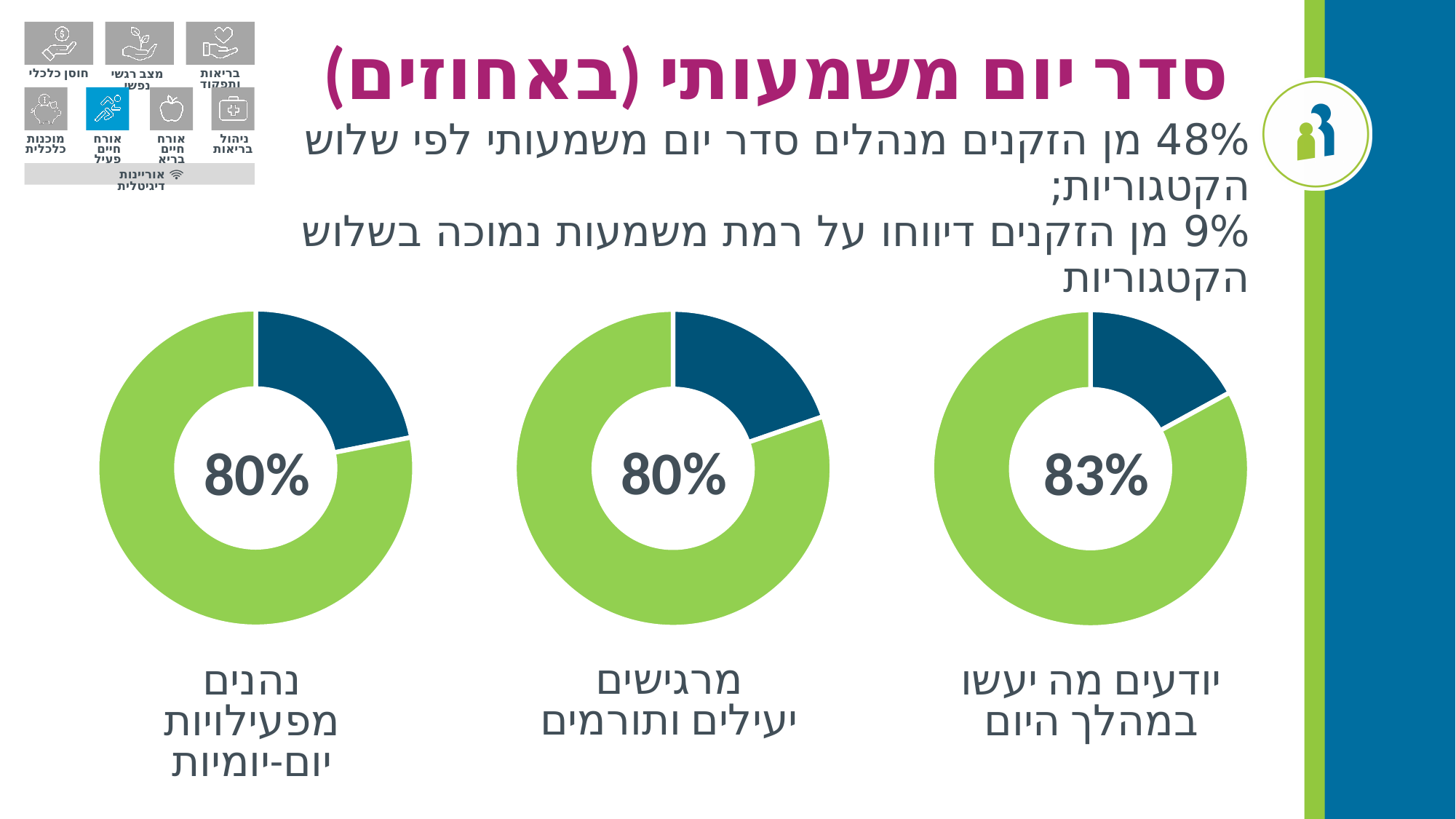
In the right donut chart (יודעים מה יעשו במהלך היום), what percentage is shown in the centre? 83% Which of the three donut charts shows the highest percentage? יודעים מה יעשו במהלך היום (83%) How many donut charts are shown on the slide? 3 Which colour represents the highlighted percentage in each donut chart? Green Do the left and middle donut charts show the same percentage? Yes, both show 80% In the right donut chart, what share of the ring is coloured green? 83% Is the percentage in the right donut chart (יודעים מה יעשו במהלך היום) larger than the percentage in the middle donut chart (מרגישים יעילים ותורמים)? Yes, 83% vs 80% In the left donut chart (נהנים מפעילויות יום-יומיות), what percentage is shown in the centre? 80% In the middle donut chart (מרגישים יעילים ותורמים), what percentage is shown in the centre? 80% What is the difference between the percentage in the right donut chart (83%) and the percentage in the left donut chart (80%)? 3 percentage points What is the label under the left donut chart? נהנים מפעילויות יום-יומיות What kind of chart is used for the three figures on the slide? Donut (pie) chart